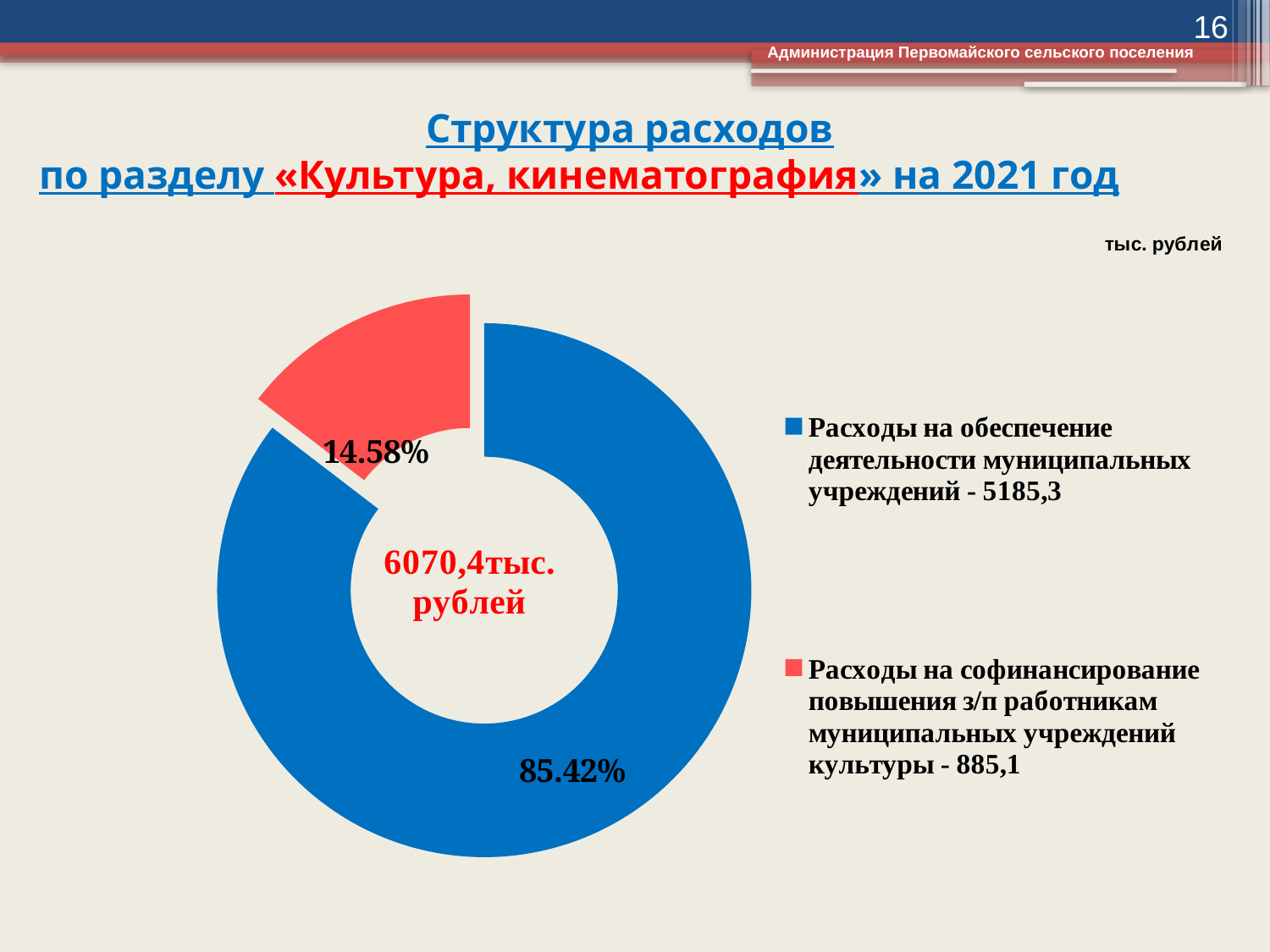
By how many percentage points does the 85.42% slice exceed the 14.58% slice? 70.84% Which category has the smallest slice of the chart? Расходы на софинансирование повышения з/п работникам муниципальных учреждений культуры What share of the chart does the slice for «Расходы на обеспечение деятельности муниципальных учреждений» represent? 85.42% Which is larger: the slice for «Расходы на обеспечение деятельности муниципальных учреждений» or the slice for «Расходы на софинансирование повышения з/п работникам муниципальных учреждений культуры»? Расходы на обеспечение деятельности муниципальных учреждений Which category has the largest slice of the chart? Расходы на обеспечение деятельности муниципальных учреждений What is the total amount shown in the centre of the chart? 6070,4 тыс. рублей What share of the chart does the slice for «Расходы на софинансирование повышения з/п работникам муниципальных учреждений культуры» represent? 14.58% What type of chart is shown on the slide? doughnut (pie) chart How many categories does the chart show? 2 What is the difference between the two legend values, 5185,3 and 885,1? 4300,2 What is the value shown in the legend for «Расходы на софинансирование повышения з/п работникам муниципальных учреждений культуры»? 885,1 What is the value shown in the legend for «Расходы на обеспечение деятельности муниципальных учреждений»? 5185,3